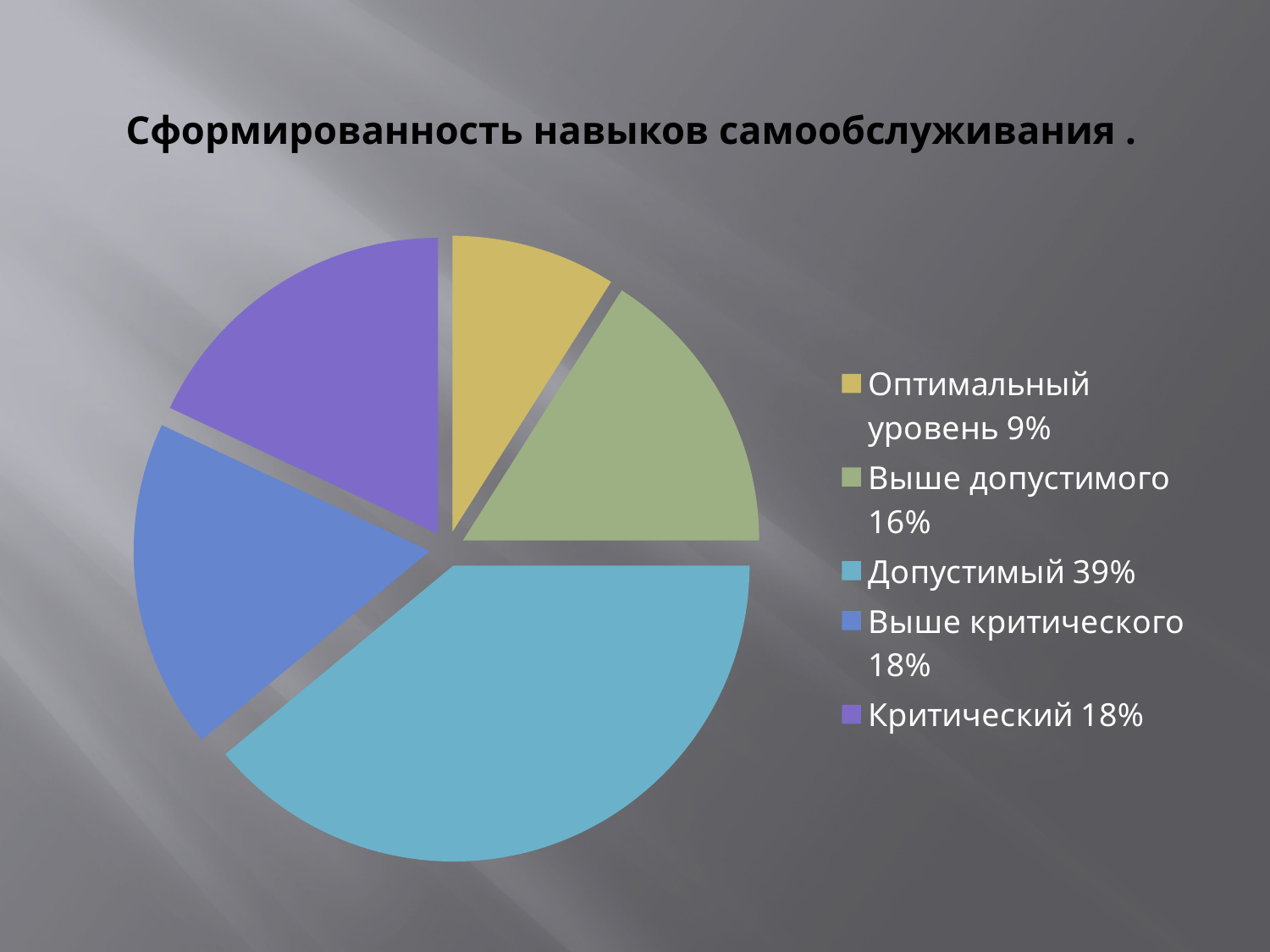
Which category has the smallest share of the pie? Оптимальный уровень What is the title of the chart? Сформированность навыков самообслуживания . How many slices does the pie chart have? 5 What is the difference in percentage points between "Допустимый" and "Выше допустимого"? 23 What percentage is shown for "Оптимальный уровень"? 9% What share of the pie is labelled "Допустимый"? 39% Which is larger, the share for "Выше критического" or the share for "Оптимальный уровень"? Выше критического What percentage is shown for "Критический"? 18% What percentage is shown for "Выше допустимого"? 16% What kind of chart is shown on the slide? pie chart What colour is the "Допустимый" slice? light blue Which category has the largest share of the pie? Допустимый